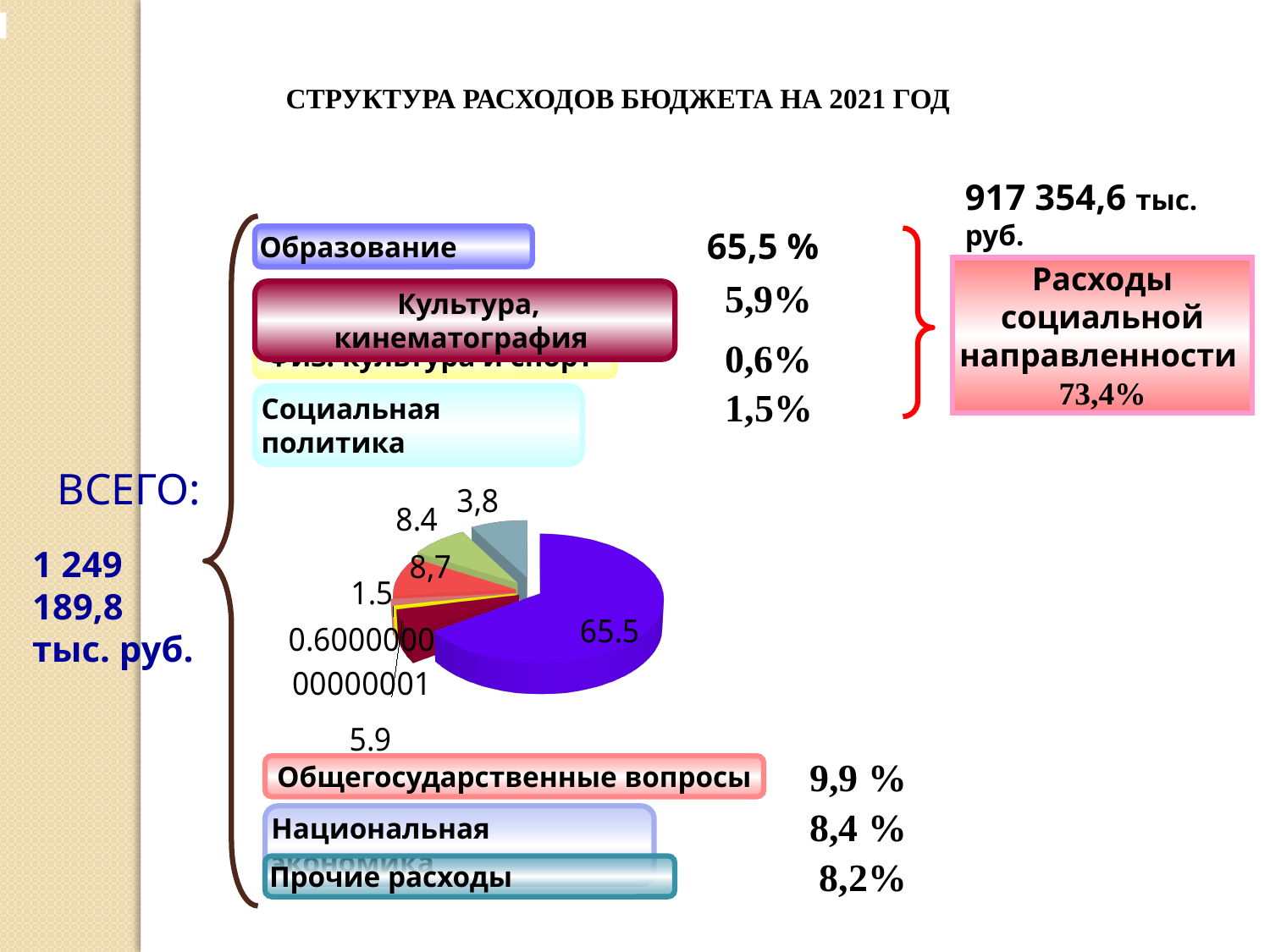
Does the pie chart have a legend? No What value is printed on the large purple slice of the pie chart? 65.5 Which is smaller in the pie chart, the slice labelled 1.5 or the slice labelled 3.8? 1.5 What is the value printed on the largest slice of the pie chart? 65.5 How many slices does the pie chart have? 7 What is the difference between the slices labelled 8.7 and 8.4 in the pie chart? 0.3 What type of chart is shown on the slide? pie chart What is the difference between the slices labelled 65.5 and 5.9 in the pie chart? 59.6 What is the title of the slide containing the pie chart? СТРУКТУРА РАСХОДОВ БЮДЖЕТА НА 2021 ГОД Which is larger in the pie chart, the slice labelled 8.4 or the slice labelled 3.8? 8.4 What share of the pie does the largest slice represent, according to its data label? 65.5